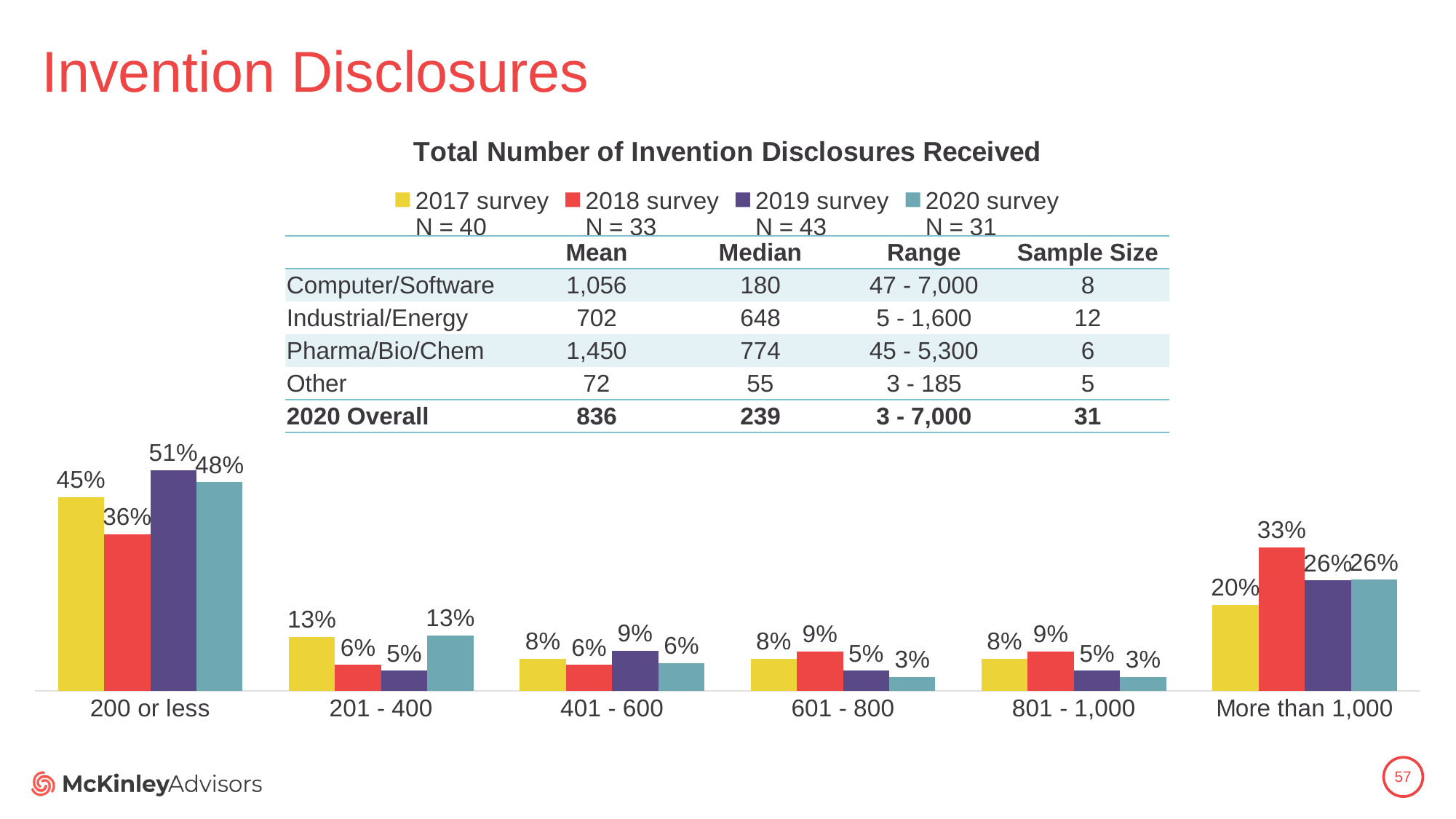
What is the title of the chart? Total Number of Invention Disclosures Received How many series does the chart legend list? 4 What is the value for the 2019 survey in the '200 or less' category? 51% Which is larger in the 'More than 1,000' category: the 2017 survey value or the 2018 survey value? 2018 survey What is the value for the 2017 survey in the '601 - 800' category? 8% Which category has the highest value for the 2020 survey? 200 or less What is the difference between the 2019 survey and 2017 survey values in the '200 or less' category? 6% What kind of chart is shown on the slide? Bar chart What is the value for the 2020 survey in the '201 - 400' category? 13% How many categories are shown on the x axis of the chart? 6 What is the value for the 2018 survey in the 'More than 1,000' category? 33% Which survey year has the lowest value in the '200 or less' category? 2018 survey